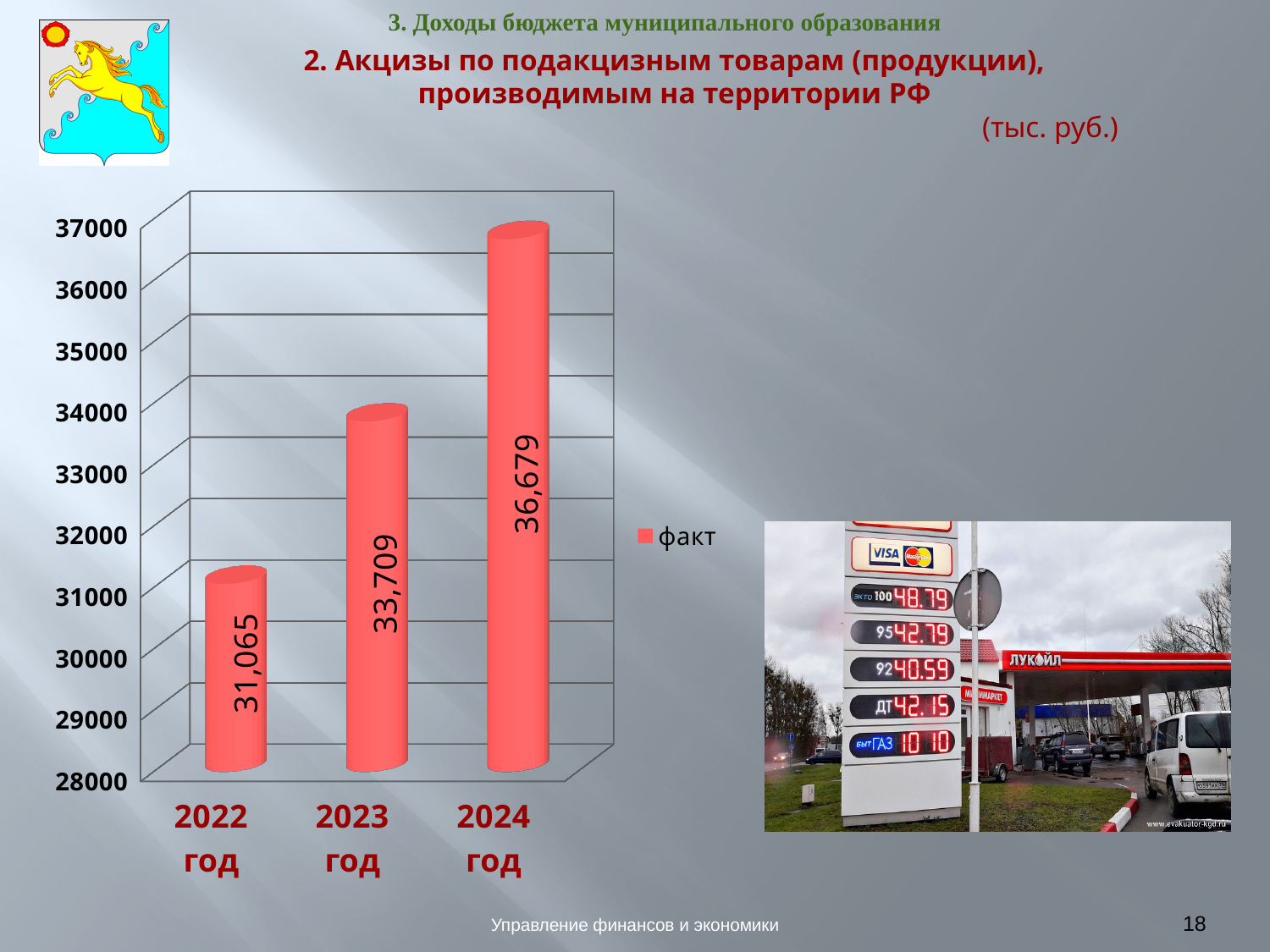
What is the value for 2022 год? 31,065 What is the difference between the values for 2023 год and 2022 год? 2,644 Do the values rise or fall from 2022 год to 2024 год? rise Which is larger, the value for 2022 год or the value for 2023 год? 2023 год Which year has the highest value? 2024 год What is the difference between the values for 2024 год and 2023 год? 2,970 Is the value for 2024 год greater or less than 36000? greater What is the value for 2023 год? 33,709 Which year has the lowest value? 2022 год How many series does the legend list? 1 What is the value for 2024 год? 36,679 How many years are shown on the chart? 3